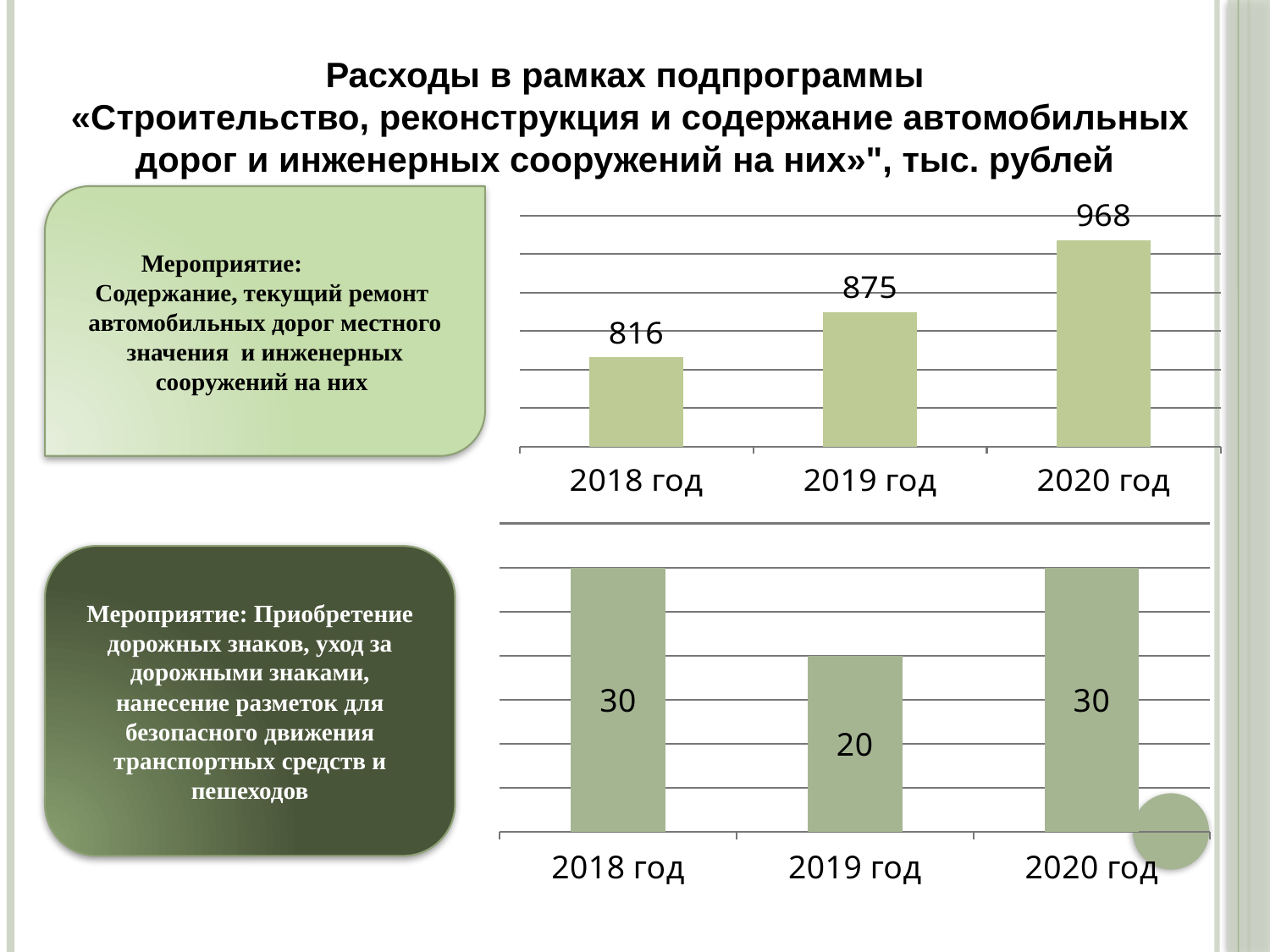
In the top chart, what is the difference between the values for 2020 год and 2018 год? 152 In the top chart, which year has the highest value? 2020 год What type of chart is the top chart? bar chart How many bars does the bottom chart show? 3 In the top chart, what is the value for 2019 год? 875 In the top chart, do the values rise or fall from 2018 год to 2020 год? rise In the bottom chart, what is the difference between the values for 2018 год and 2019 год? 10 In the bottom chart, which year has the lowest value? 2019 год In the top chart, which year has the lowest value? 2018 год In the top chart, what is the value for 2020 год? 968 In the bottom chart, what is the value for 2018 год? 30 In the bottom chart, what is the value for 2019 год? 20